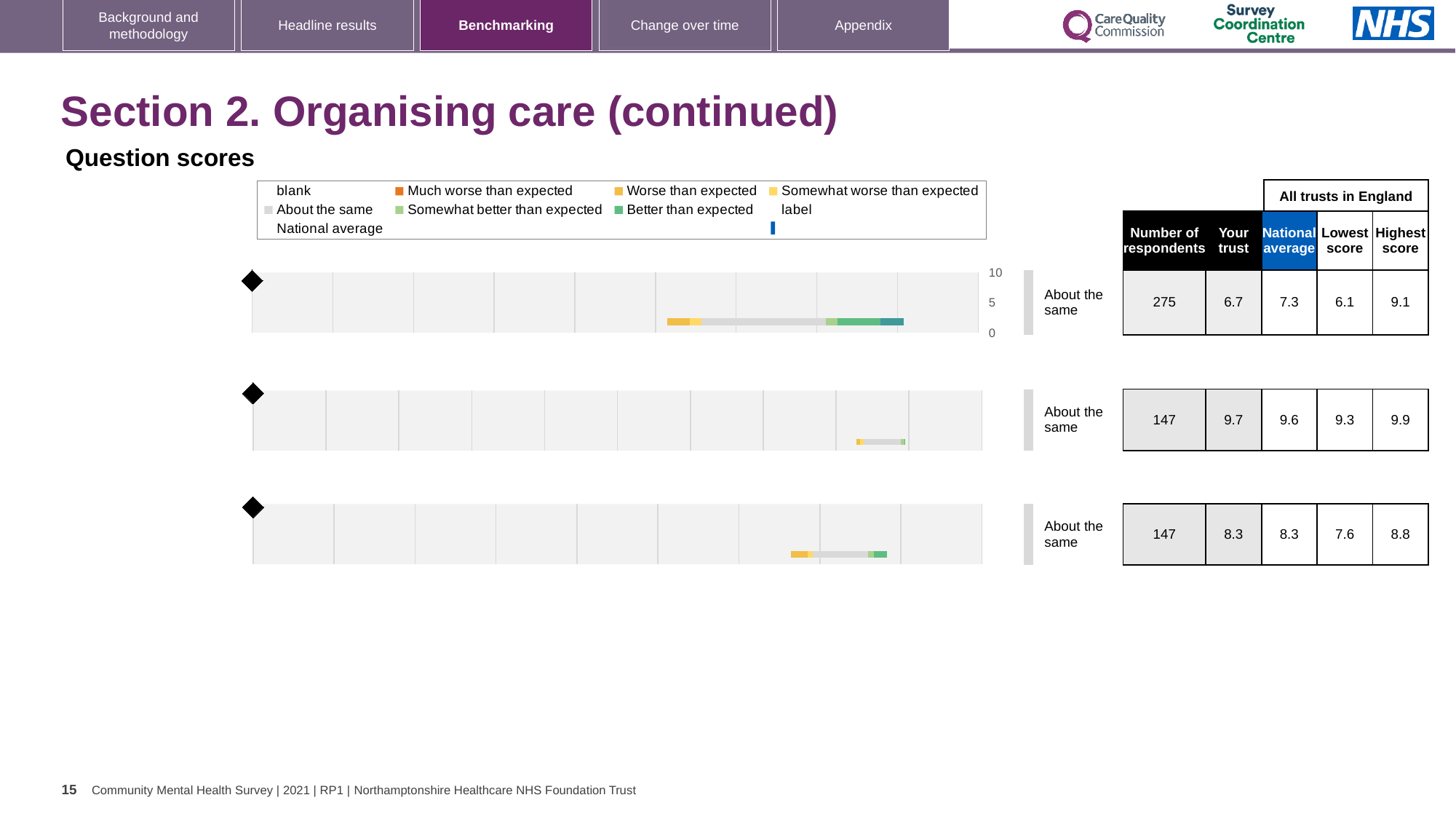
For the top chart, how many respondents are shown in the table beside it? 275 For the middle chart, what is the difference between the highest score and the lowest score in the table beside it? 0.6 What kind of chart is used for the three benchmarking charts on this slide? bar chart Which chart (top, middle or bottom) has the highest 'Your trust' score? middle For the bottom chart, what is the highest score shown in the table beside it? 8.8 In the legend, what colour represents 'Much worse than expected'? orange What benchmark category label is shown next to each of the three charts? About the same For the middle chart, what is the national average shown in the table beside it? 9.6 For the top chart, which is larger: the 'Your trust' score or the national average? National average For the top chart, is the 'Your trust' score greater or less than 5? greater For the top chart, what is the 'Your trust' score shown in the table beside it? 6.7 How many benchmarking charts are shown on the slide? 3